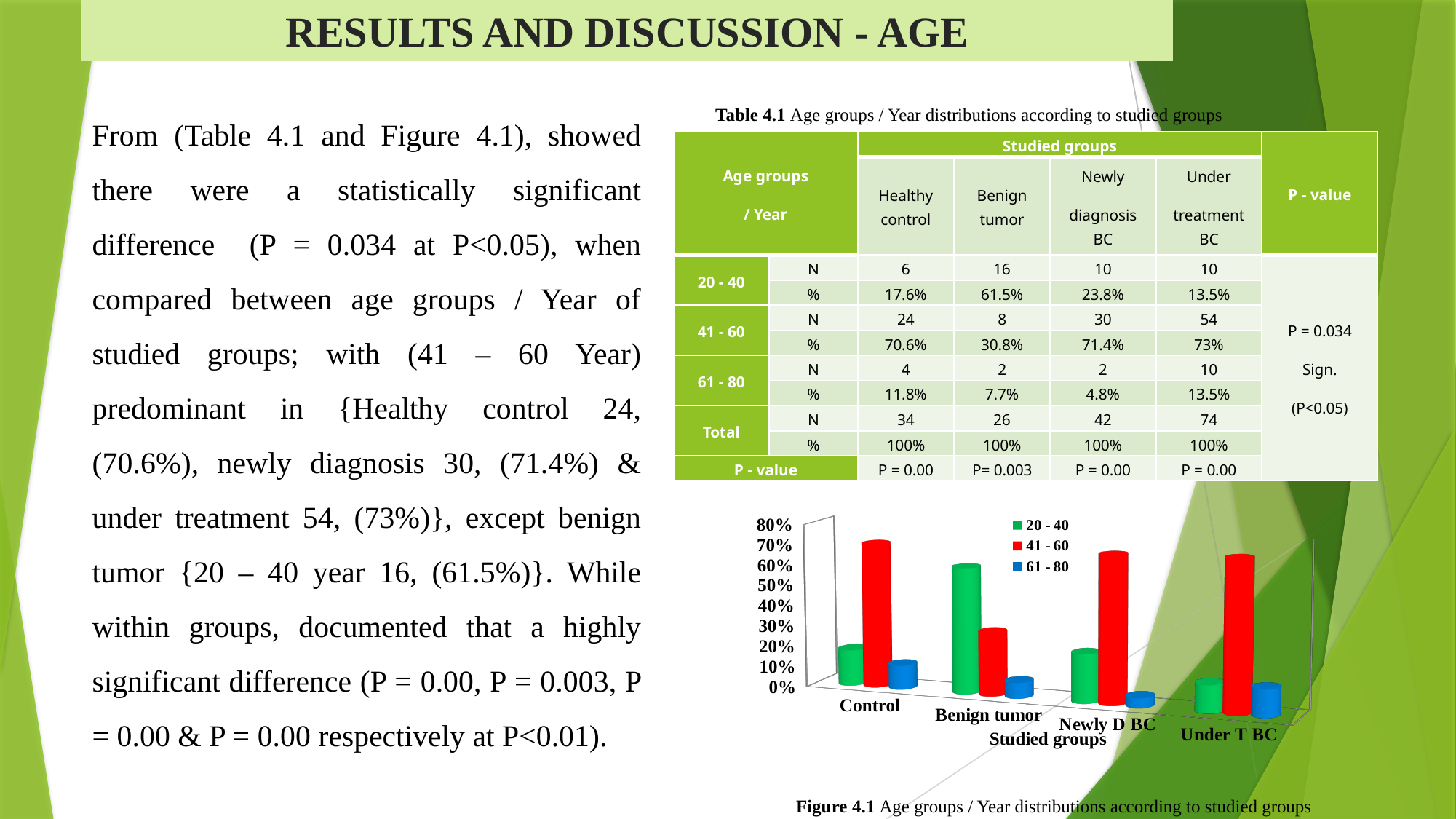
In Figure 4.1, which age group has the tallest bar for Control? 41 - 60 In Figure 4.1, which is larger: the 20 - 40 bar for Benign tumor or the 20 - 40 bar for Control? Benign tumor How many studied groups are shown along the x axis of Figure 4.1? 4 In Figure 4.1, is the 20 - 40 value for Under T BC greater or less than 20%? less In Figure 4.1, is the 61 - 80 value for Benign tumor greater or less than 10%? less In Figure 4.1, is the 41 - 60 value for Control greater or less than 60%? greater In Figure 4.1, which colour represents the 61 - 80 age group? blue In Figure 4.1, which age group has the shortest bar for Newly D BC? 61 - 80 What is the x-axis title of Figure 4.1? Studied groups What kind of chart is Figure 4.1? bar chart How many series does the legend of Figure 4.1 list? 3 In Figure 4.1, which age group has the tallest bar for Benign tumor? 20 - 40